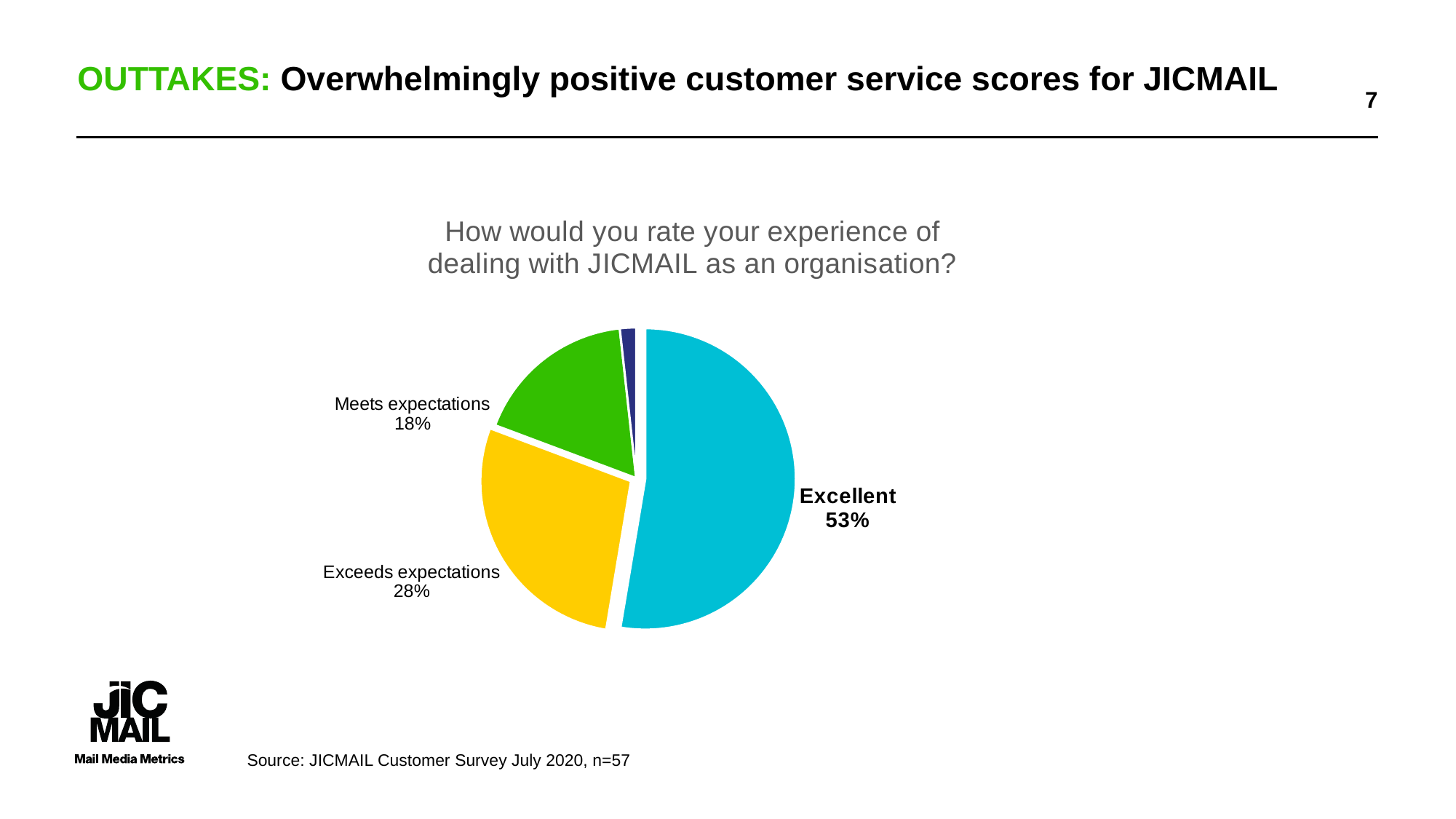
Of the labelled slices, which has the smallest share? Meets expectations What colour is the Excellent slice? Light blue (cyan) What share of the pie is labelled Exceeds expectations? 28% What percentage is shown for Meets expectations? 18% Which is larger: the share for Exceeds expectations or for Meets expectations? Exceeds expectations What type of chart is shown on the slide? Pie chart Which category has the largest slice of the pie? Excellent What is the difference between the Exceeds expectations and Meets expectations shares? 10 percentage points What question is the pie chart titled with? How would you rate your experience of dealing with JICMAIL as an organisation? What percentage of respondents rated their experience of dealing with JICMAIL as Excellent? 53% How many percentage points higher is Excellent than Exceeds expectations? 25 percentage points How many slices does the pie chart contain? 4